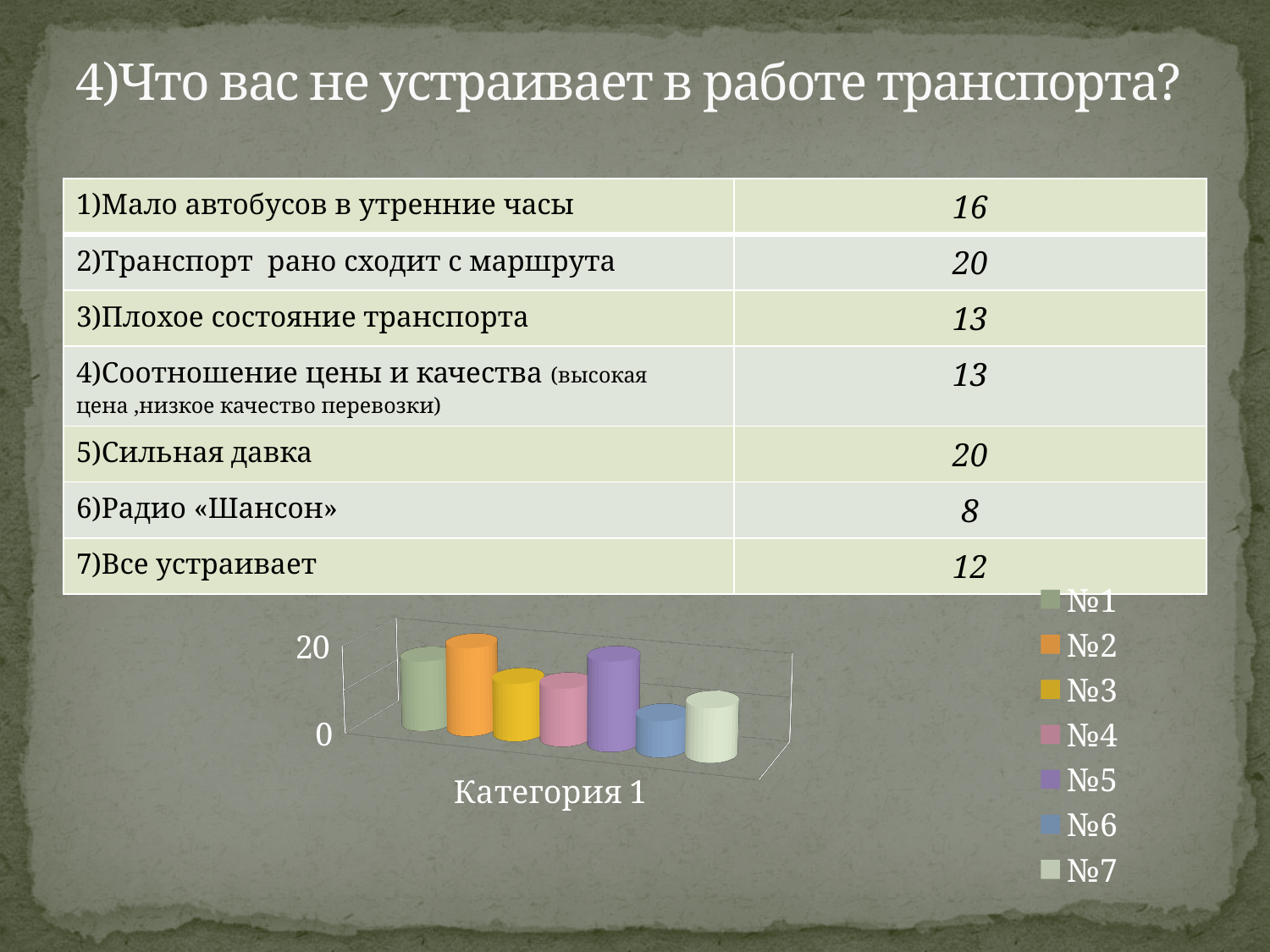
How many series does the chart legend list? 7 What kind of chart is shown on the slide? bar chart In the chart, which bar is taller: series №5 or series №3? №5 In the chart, which bar is taller: series №2 or series №6? №2 Is the value for series №7 in the chart greater or less than 20? less How many categories are shown on the chart's x axis? 1 What is the label of the single category on the chart's x axis? Категория 1 What is the highest tick value shown on the chart's vertical axis? 20 Which series has the lowest bar in the chart? №6 Is the value for series №3 in the chart greater or less than 20? less In the chart, which bar is taller: series №1 or series №7? №1 Is the value for series №6 in the chart greater or less than 20? less